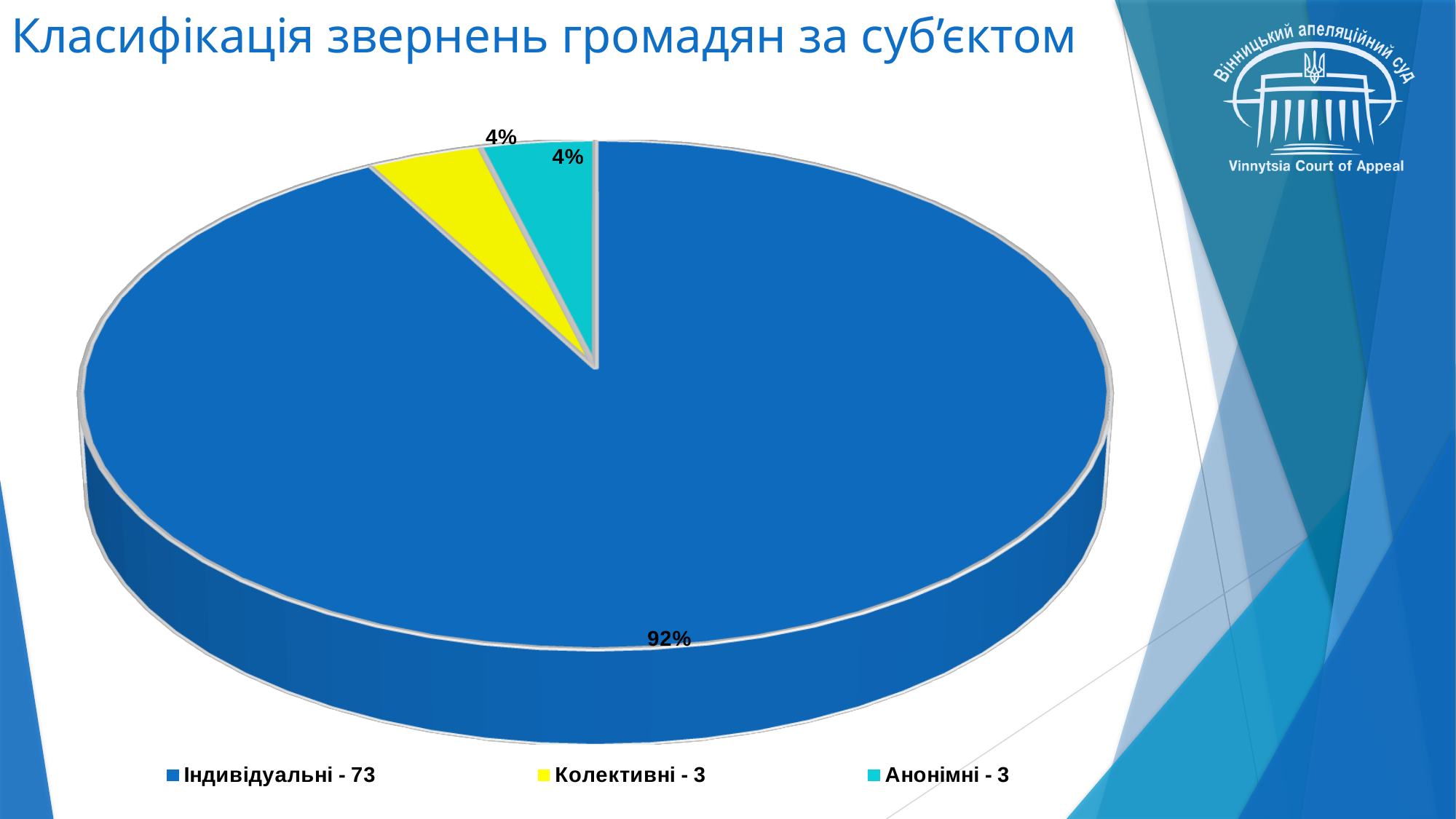
What kind of chart is shown on the slide? pie chart What share of the pie does the Індивідуальні slice represent? 92% What share of the pie does the Анонімні slice represent? 4% Which is larger, the Індивідуальні slice or the Анонімні slice? Індивідуальні What share of the pie does the Колективні slice represent? 4% How many slices does the pie chart have? 3 According to the legend, how many Колективні appeals are there? 3 What colour is the Колективні slice? yellow According to the legend, how many Індивідуальні appeals are there? 73 What is the difference between the number of Індивідуальні appeals and the number of Колективні appeals shown in the legend? 70 What is the title of the slide? Класифікація звернень громадян за суб'єктом Which category has the largest slice of the pie? Індивідуальні